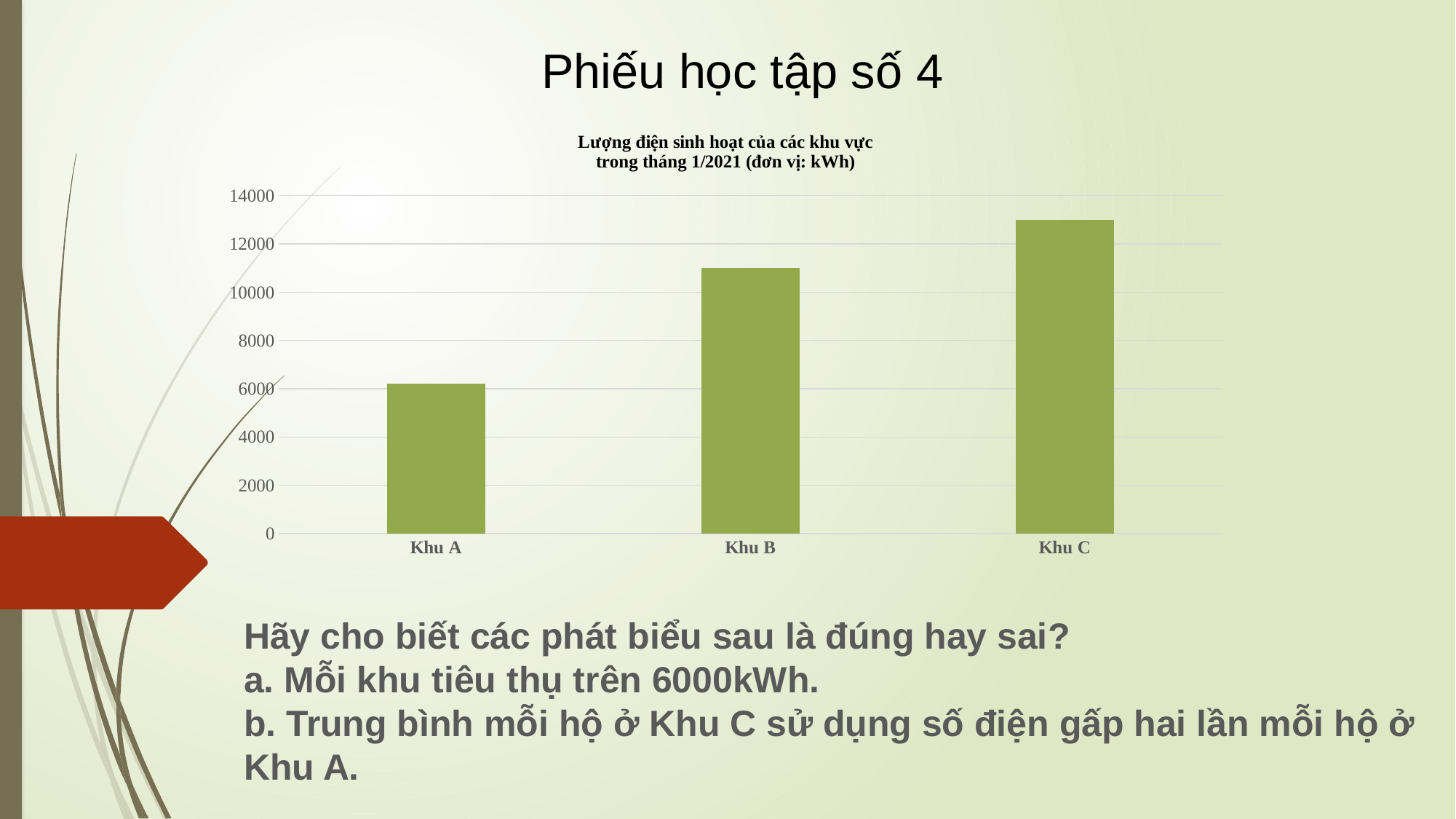
What is the title of the chart? Lượng điện sinh hoạt của các khu vực trong tháng 1/2021 (đơn vị: kWh) Is the value for Khu A greater or less than 4000? greater How many areas (khu) are shown on the x axis of the chart? 3 Is the value for Khu A greater or less than 8000? less What unit of measurement does the chart title state? kWh Is the value for Khu B greater or less than 10000? greater What kind of chart is shown on the slide? bar chart Which area has the highest electricity consumption in the chart? Khu C Do the values rise or fall from Khu A to Khu C along the x axis? rise Which area has the lowest electricity consumption in the chart? Khu A Which has the larger value, Khu A or Khu B? Khu B